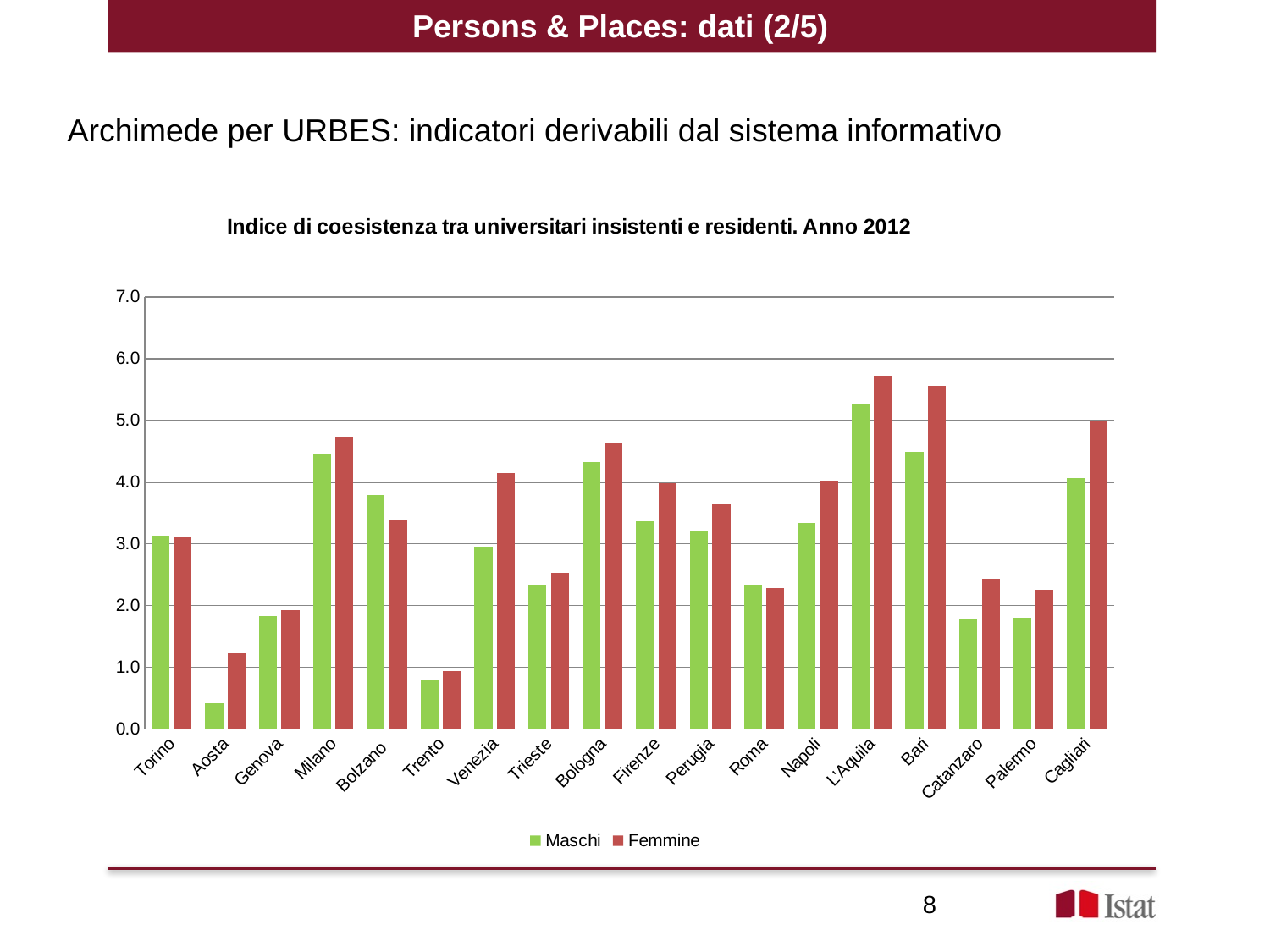
Which city has the highest Maschi value? L'Aquila Which city has the lowest Femmine value? Trento What is the title of the chart? Indice di coesistenza tra universitari insistenti e residenti. Anno 2012 Which city has the lowest Maschi value? Aosta For Venezia, which is larger, the Maschi value or the Femmine value? Femmine How many cities are shown on the x axis? 18 Is the Maschi value for Milano greater or less than 4.0? greater What kind of chart is shown on the slide? bar chart For Bolzano, which is larger, the Maschi value or the Femmine value? Maschi How many series does the legend list? 2 Is the Femmine value for Bologna greater or less than 4.0? greater Is the Femmine value for Trento greater or less than 1.0? less